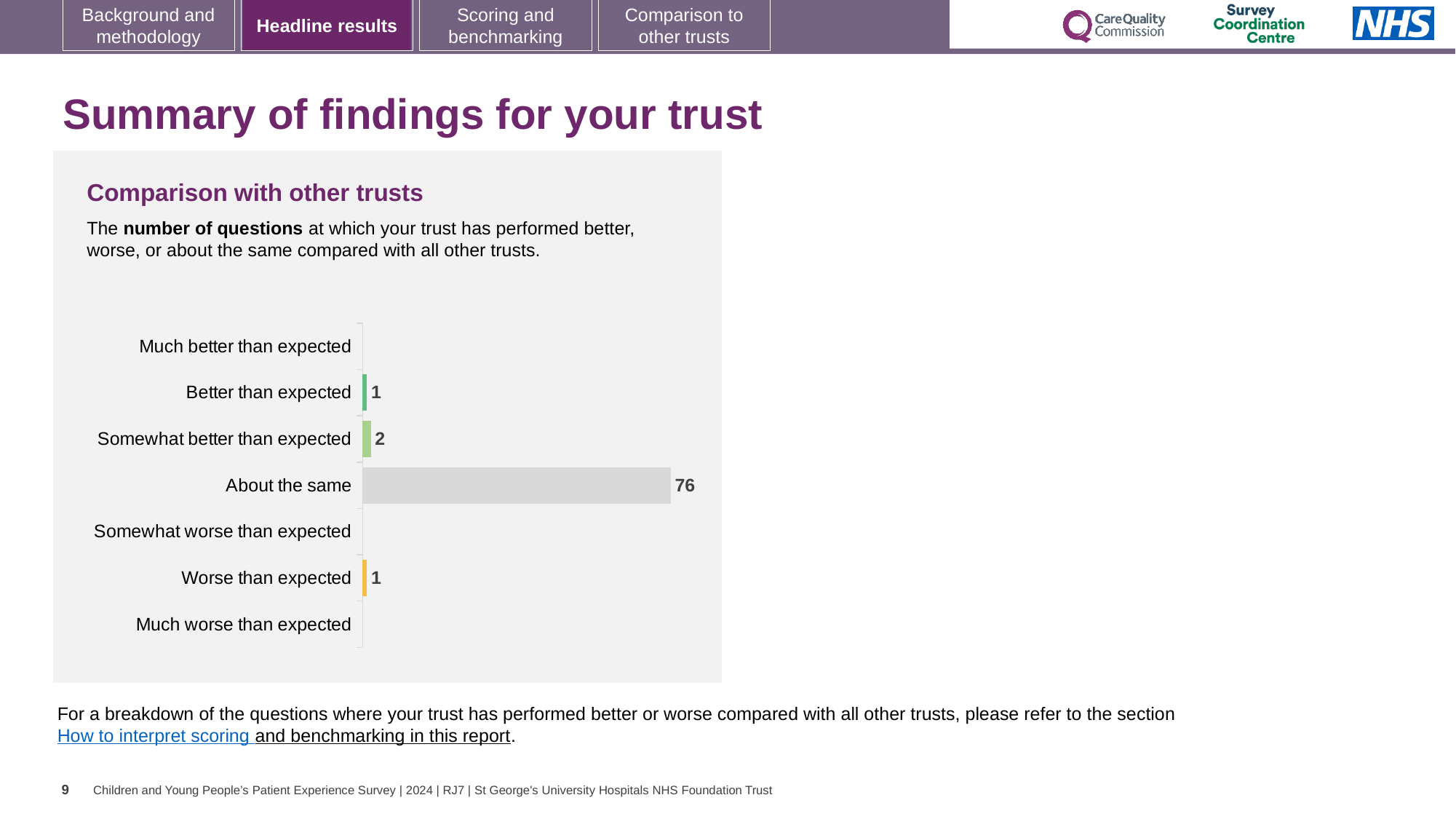
How many categories are shown on the chart's axis? 7 What is the difference between the values for 'Somewhat better than expected' and 'Better than expected'? 1 What is the difference between the values for 'About the same' and 'Somewhat better than expected'? 74 What kind of chart is shown on the slide? Bar chart What colour is the bar for 'Worse than expected'? Orange What is the value for 'Somewhat better than expected'? 2 Which is larger, the value for 'Somewhat better than expected' or the value for 'Worse than expected'? Somewhat better than expected What is the value for 'About the same'? 76 What is the value for 'Worse than expected'? 1 What is the title of the chart section? Comparison with other trusts Which category has the highest value? About the same What is the value for 'Better than expected'? 1